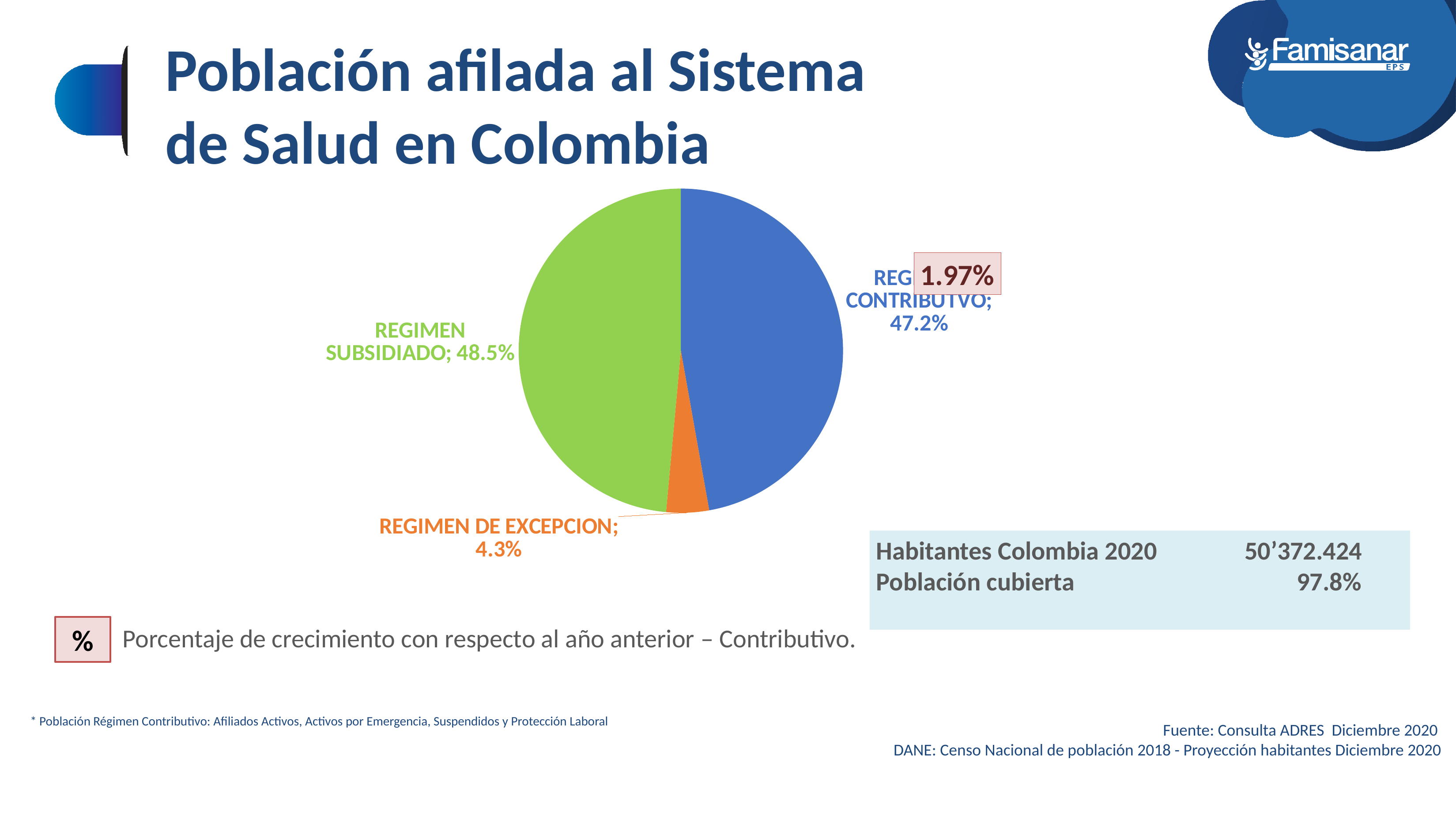
What share of the pie does REGIMEN SUBSIDIADO represent? 48.5% Which regime has the smallest slice of the pie? REGIMEN DE EXCEPCION Which is larger, the share for REGIMEN CONTRIBUTIVO or for REGIMEN DE EXCEPCION? REGIMEN CONTRIBUTIVO What colour is the REGIMEN DE EXCEPCION slice? Orange What share of the pie does REGIMEN CONTRIBUTIVO represent? 47.2% Which regime has the largest slice of the pie? REGIMEN SUBSIDIADO What is the difference in percentage points between REGIMEN SUBSIDIADO and REGIMEN DE EXCEPCION? 44.2 How many slices does the pie chart have? 3 What share of the pie does REGIMEN DE EXCEPCION represent? 4.3% What is the difference in percentage points between REGIMEN SUBSIDIADO and REGIMEN CONTRIBUTIVO? 1.3 What type of chart is shown on the slide? Pie chart What colour is the REGIMEN SUBSIDIADO slice? Green